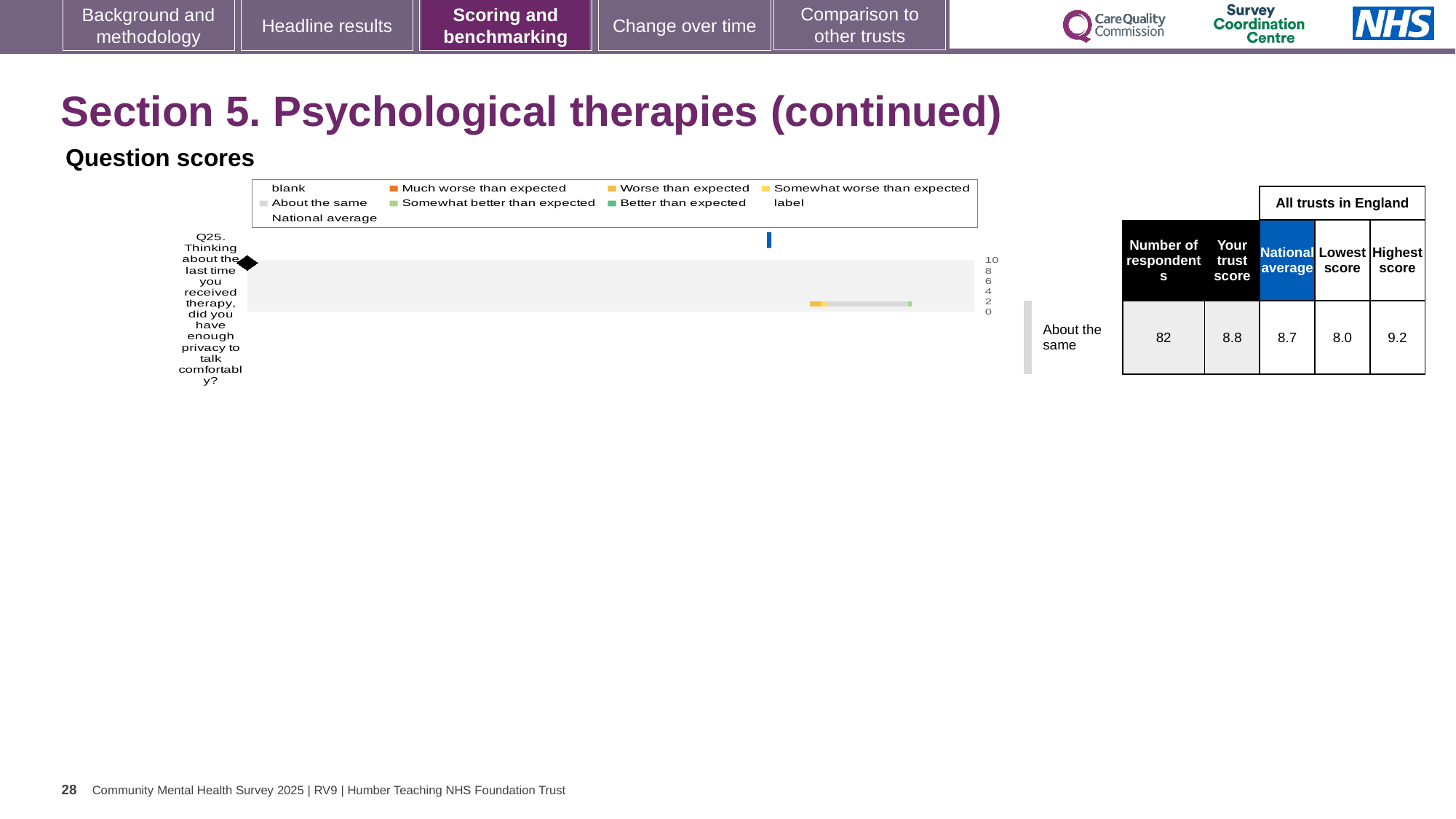
Which question number is plotted in the Question scores chart? Q25 What is the national average score for Q25? 8.7 What is the difference between the highest score and the lowest score for Q25? 1.2 According to the table next to the chart, which benchmark category does Q25 fall into? About the same How many respondents answered Q25? 82 What is the lowest score among all trusts in England for Q25? 8.0 What is the trust's score for Q25 shown in the table beside the chart? 8.8 Which is larger for Q25: the trust's score or the national average? the trust's score What is the highest score among all trusts in England for Q25? 9.2 By how much does the trust's score for Q25 exceed the national average? 0.1 What kind of chart is shown under 'Question scores'? bar chart How many questions (categories) are plotted in the Question scores chart? 1